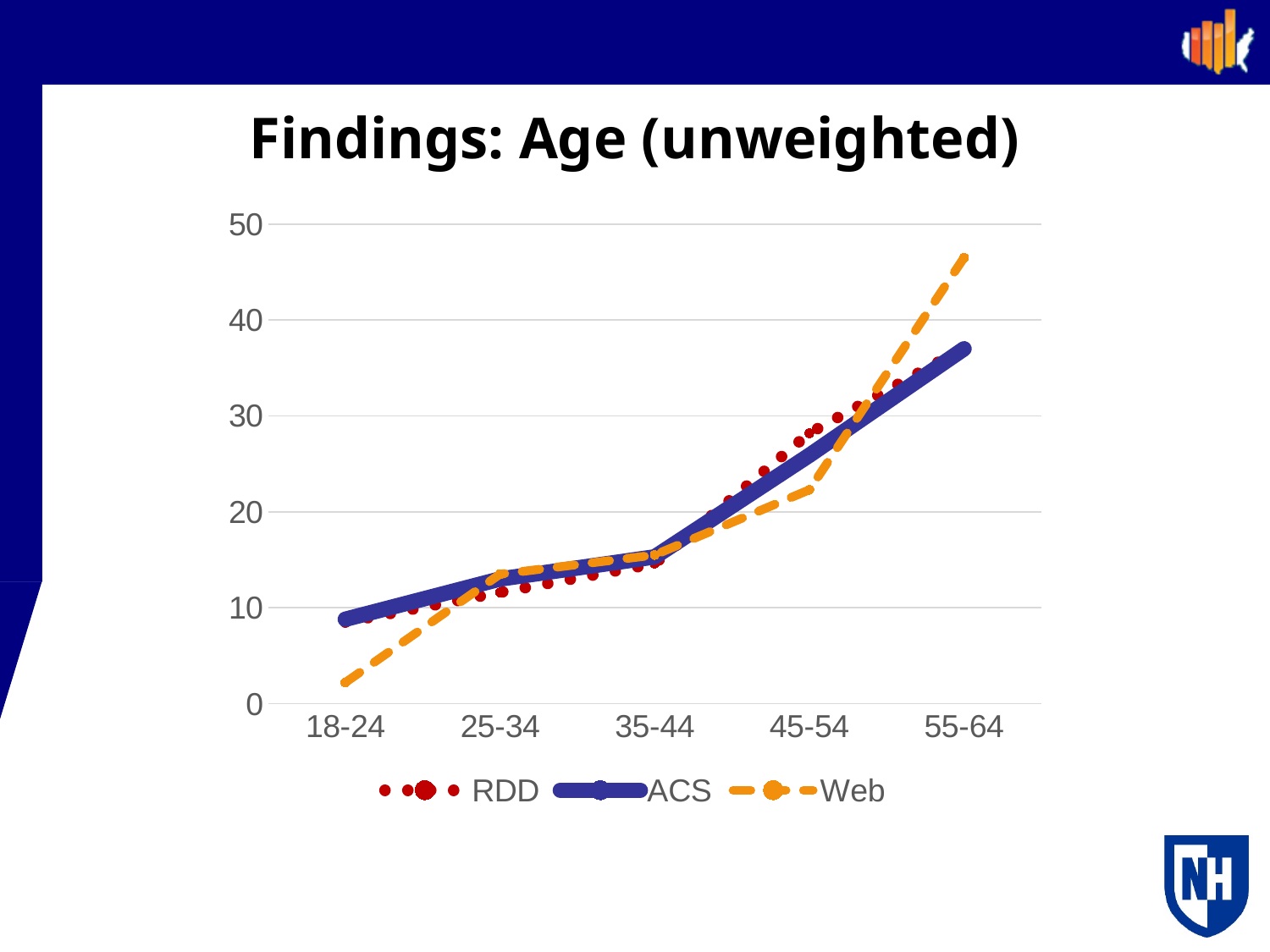
At 45-54, which is larger: the ACS value or the Web value? ACS Do the values for the Web series rise or fall from 18-24 to 55-64? rise How many age groups are shown on the x axis? 5 Is the value for Web at 18-24 greater or less than 10? less What kind of chart is shown on the slide? line chart Which series has the highest value at 55-64? Web Which series is drawn with an orange dashed line? Web Which age group has the lowest value for the Web series? 18-24 How many series does the legend list? 3 Is the value for Web at 55-64 greater or less than 40? greater What is the title of the chart? Findings: Age (unweighted) Which age group has the highest value for the Web series? 55-64